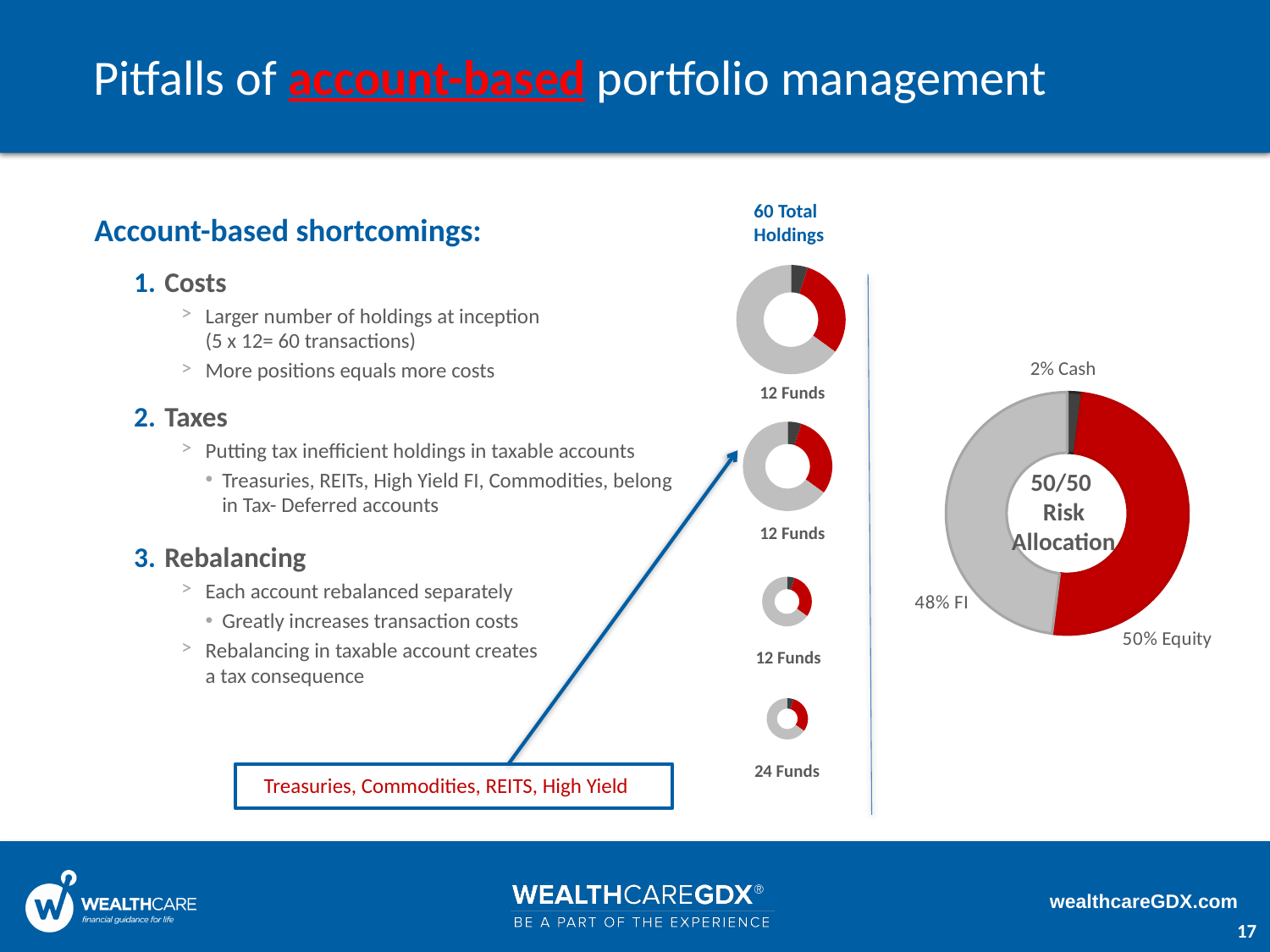
In the large donut chart on the right, what share is labelled for Cash? 2% In the large donut chart on the right, which is larger, the Equity share or the FI share? Equity In the large donut chart on the right, what is the difference between the Equity share and the FI share? 2% How many slices does the large donut chart on the right have? 3 In the large donut chart on the right, which slice is the largest? Equity In the large donut chart on the right, what share is labelled for Equity? 50% What text is written in the centre of the large donut chart on the right? 50/50 Risk Allocation What label appears under the bottom small donut chart in the '60 Total Holdings' column? 24 Funds How many small donut charts are stacked in the column under the heading '60 Total Holdings'? 4 In the large donut chart on the right, which slice is the smallest? Cash In the large donut chart on the right, what share is labelled for FI? 48% What kind of chart is the large chart on the right of the slide? Pie (donut) chart